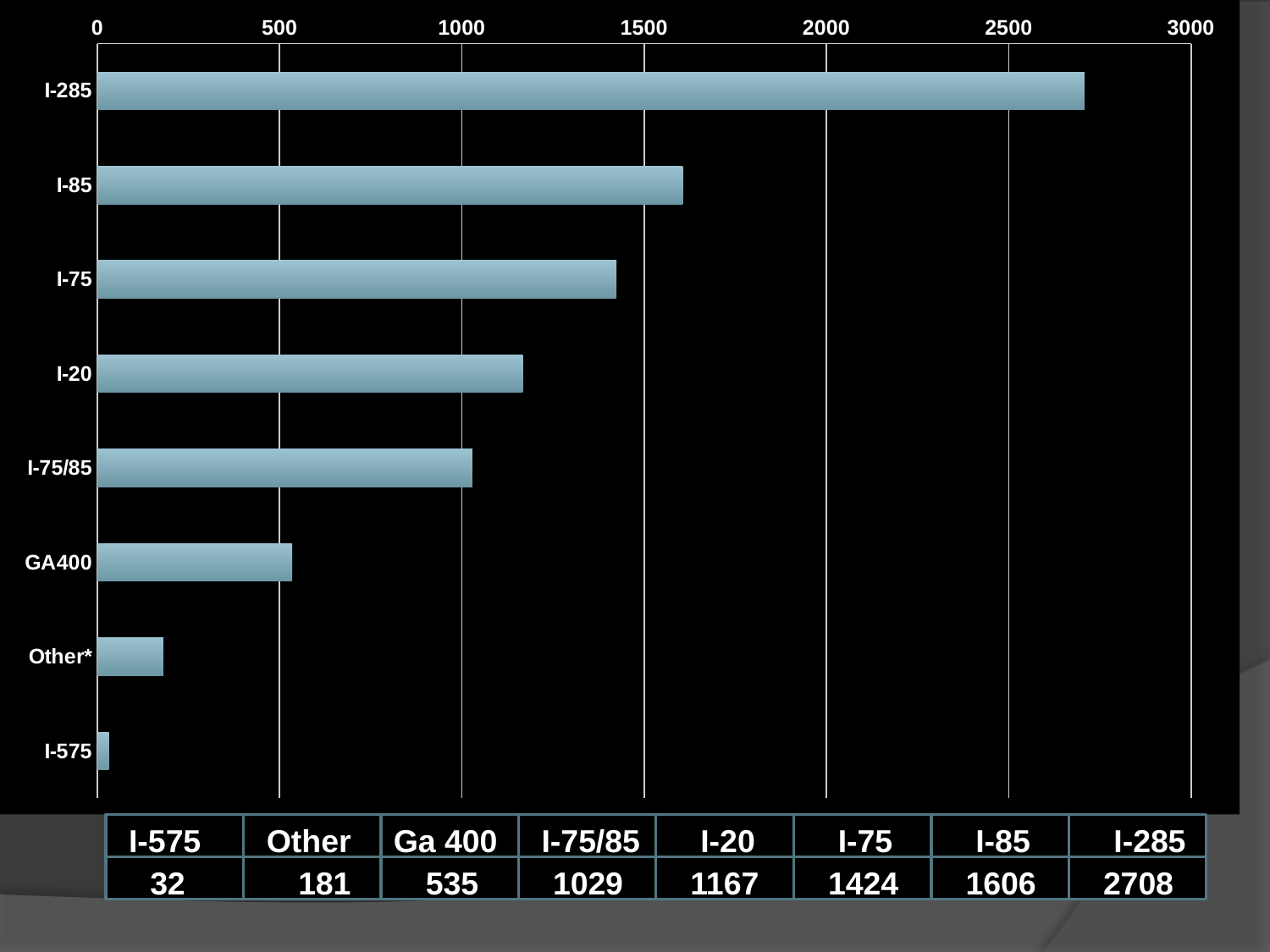
What kind of chart is shown on the slide? bar chart Is the value for I-85 greater or less than 1500? greater What is the difference between the values for I-285 and I-20? 1541 What is the value for GA400? 535 Is the value for Other* greater or less than 500? less How many categories are shown in the chart? 8 What is the value for I-75/85? 1029 What is the value for I-285? 2708 What is the difference between the values for I-85 and I-75? 182 Which category has the lowest value? I-575 Which category has the highest value? I-285 Which is larger, the value for I-20 or the value for I-75/85? I-20